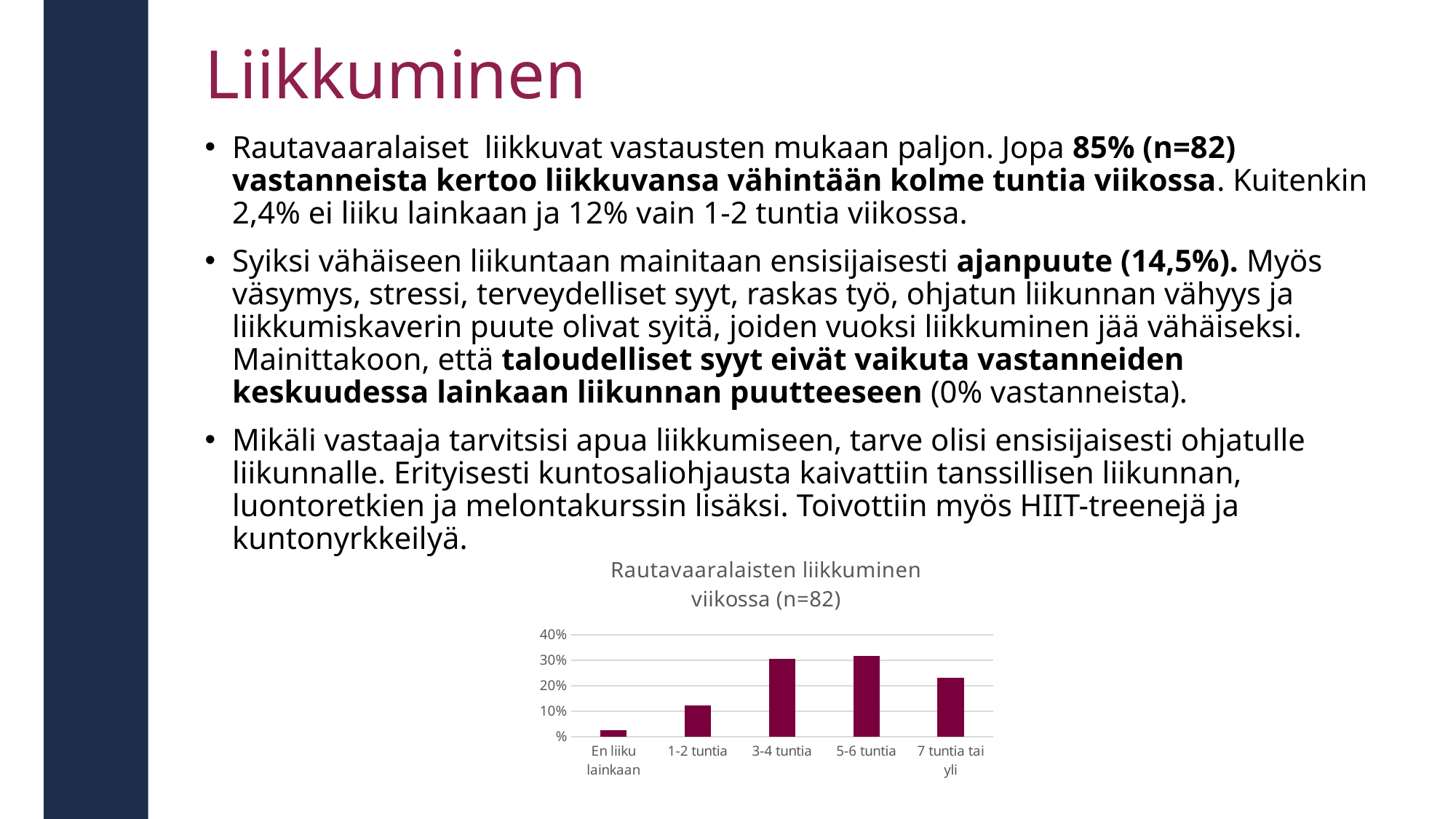
Which category has the lowest bar in the chart? En liiku lainkaan What is the title of the chart? Rautavaaralaisten liikkuminen viikossa (n=82) Is the value for 3-4 tuntia greater or less than 20%? greater How many categories are shown on the x axis of the chart? 5 Do the values rise or fall from En liiku lainkaan to 3-4 tuntia? rise Is the value for 7 tuntia tai yli greater or less than 30%? less What kind of chart is shown on the slide? bar chart Is the value for En liiku lainkaan greater or less than 10%? less Which is larger, the value for 3-4 tuntia or the value for 7 tuntia tai yli? 3-4 tuntia Which is larger, the value for 7 tuntia tai yli or the value for 1-2 tuntia? 7 tuntia tai yli